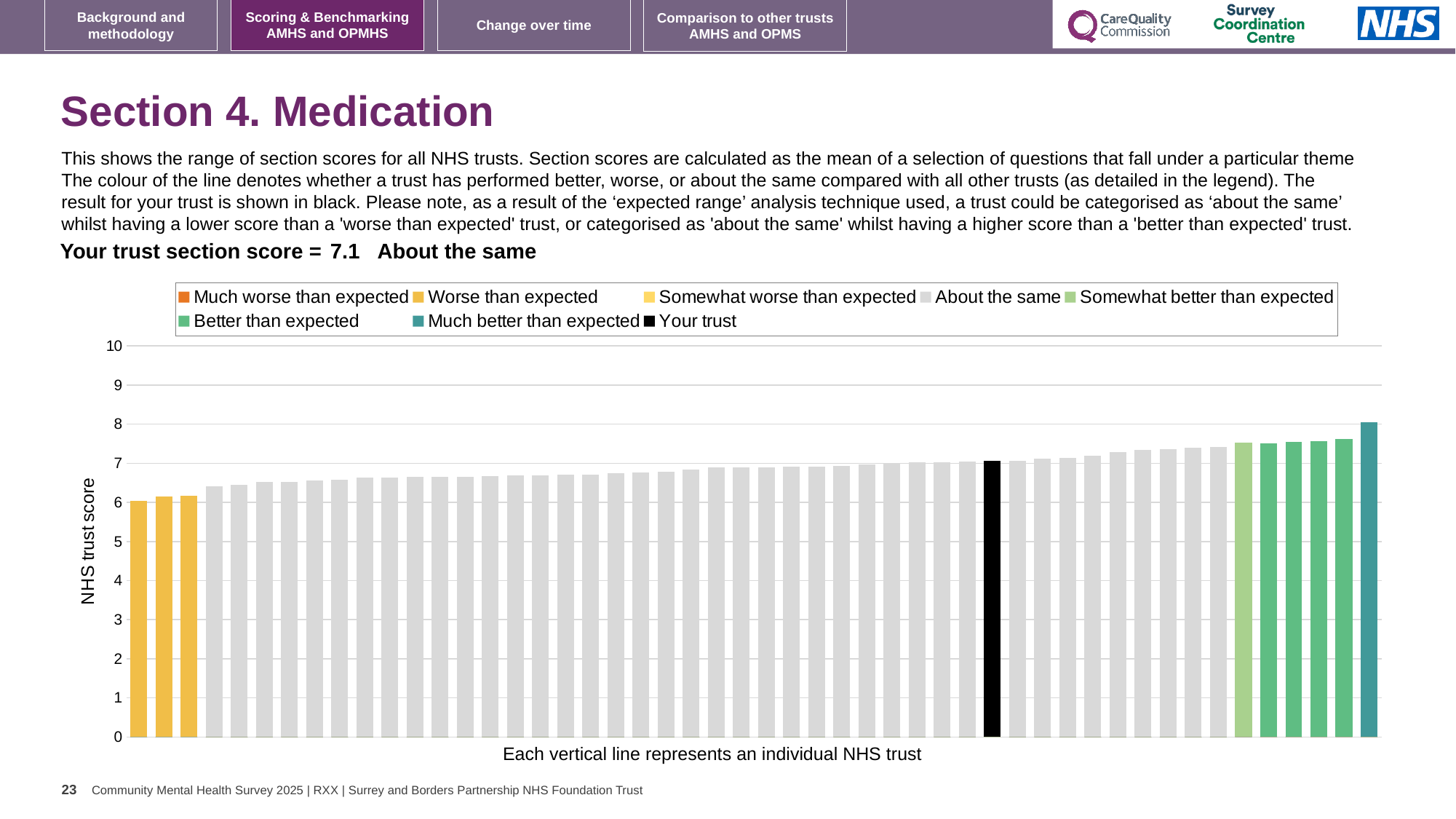
Is the value of the black 'Your trust' bar greater or less than 8? less Which legend category does the tallest bar belong to? Much better than expected How many bars are coloured as 'Much better than expected' (teal)? 1 What kind of chart is shown on the slide? bar chart What is the section score for your trust shown on the slide? 7.1 Is the value of the black 'Your trust' bar greater or less than 6? greater How many bars are coloured as 'Worse than expected' (yellow)? 3 What is the label on the vertical axis of the chart? NHS trust score Is the value of the tallest bar (the 'Much better than expected' trust) greater or less than 9? less Do the bar values rise or fall from left to right along the x axis? rise How many entries does the chart legend list? 8